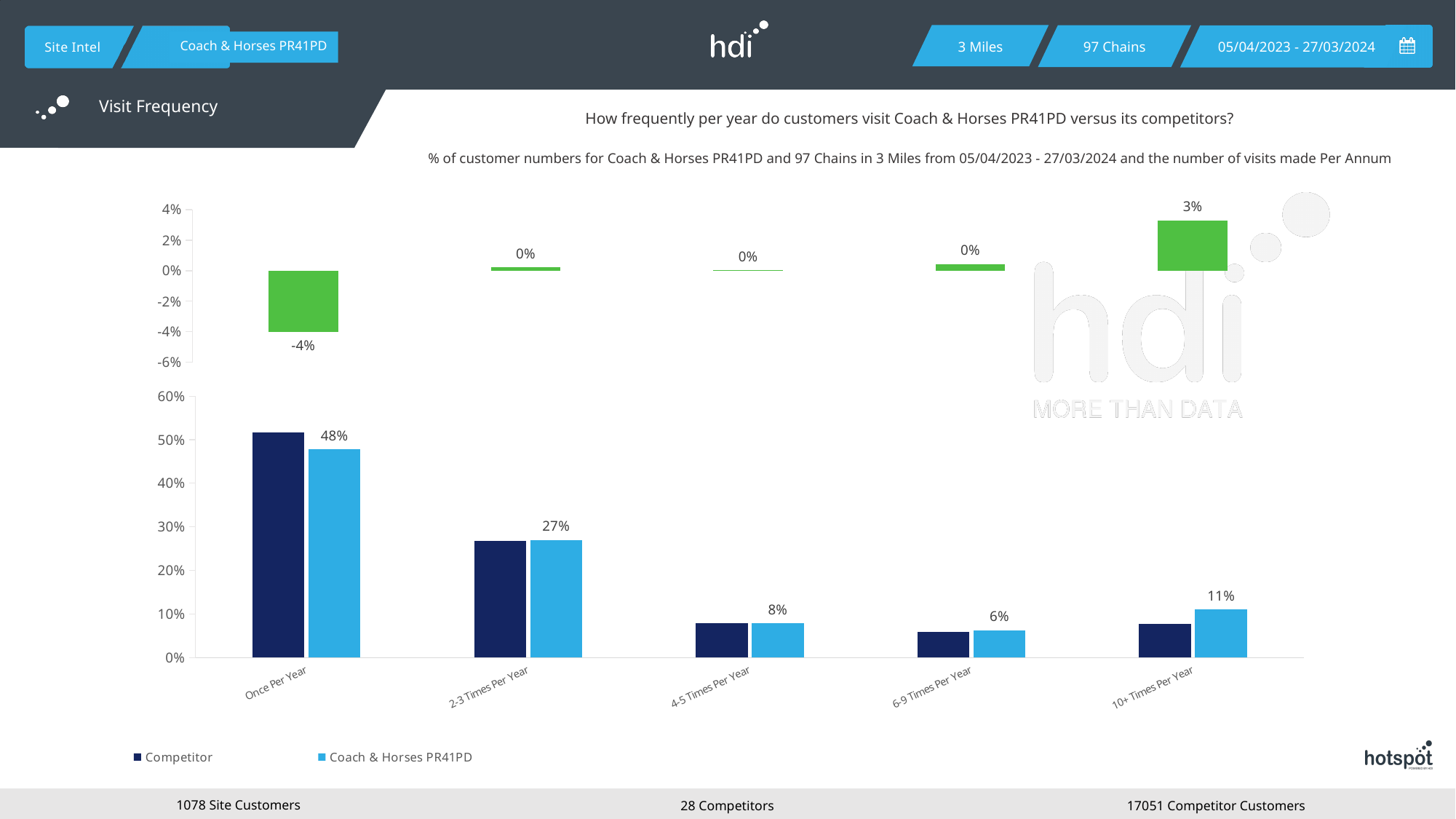
In the top chart, what is the value shown for 10+ Times Per Year? 3% In the bottom bar chart, what is the value for Coach & Horses PR41PD for 10+ Times Per Year? 11% In the bottom bar chart, which category has the highest value for Coach & Horses PR41PD? Once Per Year In the bottom bar chart, which category has the lowest value for Coach & Horses PR41PD? 6-9 Times Per Year In the bottom bar chart, what is the value for Coach & Horses PR41PD for 2-3 Times Per Year? 27% In the bottom bar chart, what is the value for Coach & Horses PR41PD for Once Per Year? 48% In the bottom bar chart, what is the difference between the Coach & Horses PR41PD values for Once Per Year and 2-3 Times Per Year? 21% In the top chart, what is the value shown for Once Per Year? -4% In the bottom bar chart, for 10+ Times Per Year, which series has the larger value, Competitor or Coach & Horses PR41PD? Coach & Horses PR41PD How many categories are shown on the x axis of the bottom bar chart? 5 How many series does the legend of the bottom bar chart list? 2 In the bottom bar chart, is the Competitor value for Once Per Year greater or less than 50%? greater